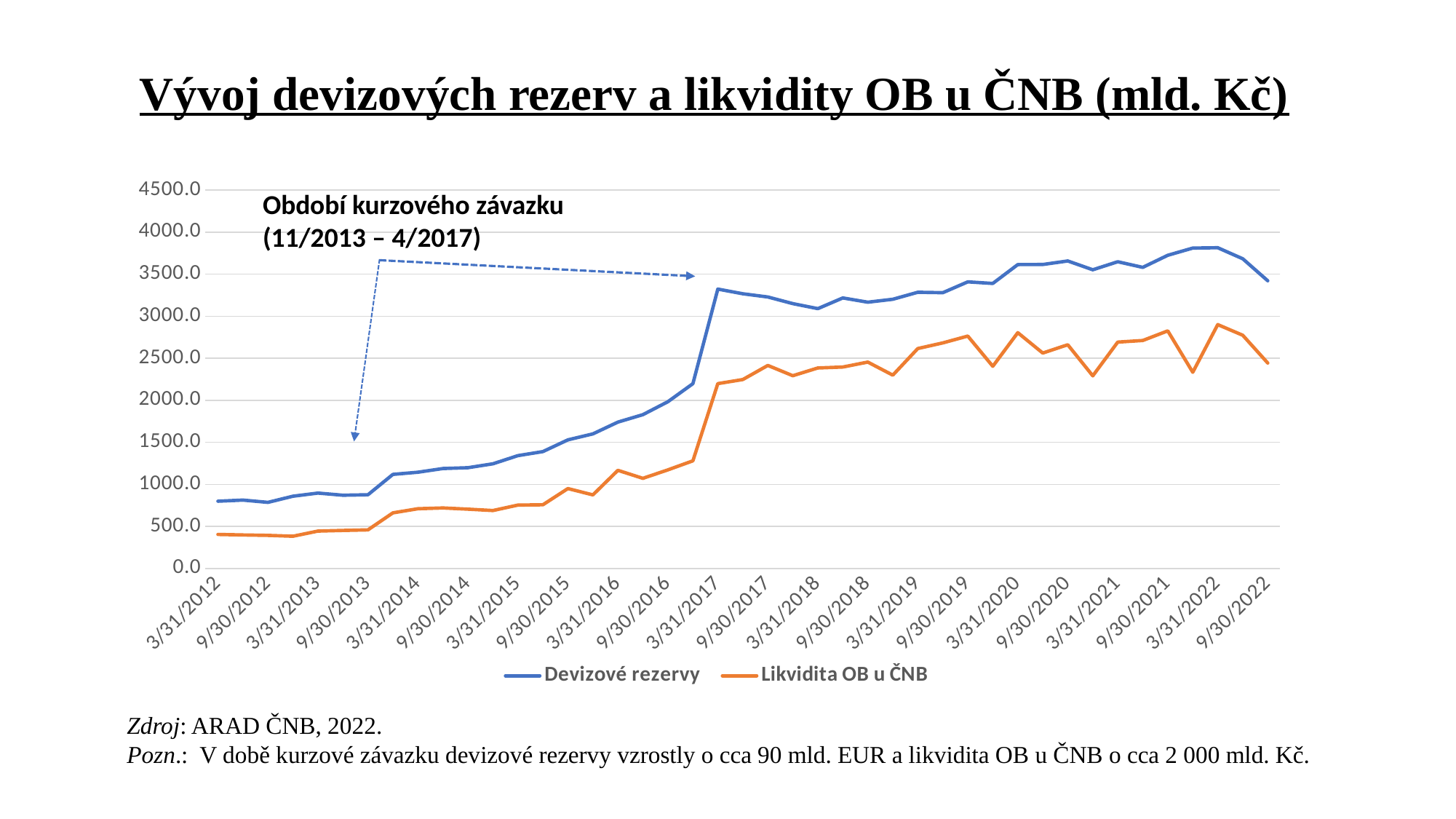
How many series does the legend list? 2 Is the value of Likvidita OB u ČNB at 3/31/2012 greater or less than 500? less Is the value of Devizové rezervy at 3/31/2022 greater or less than 3500? greater Is the value of Devizové rezervy at 3/31/2017 greater or less than 3000? greater Do the values of Devizové rezervy generally rise or fall from 3/31/2012 to 3/31/2022? rise How many date labels are shown on the x axis? 22 What kind of chart is shown on the slide? line chart What is the title of the chart? Vývoj devizových rezerv a likvidity OB u ČNB (mld. Kč) Which series is drawn in orange? Likvidita OB u ČNB At 3/31/2017, which series has the higher value, Devizové rezervy or Likvidita OB u ČNB? Devizové rezervy